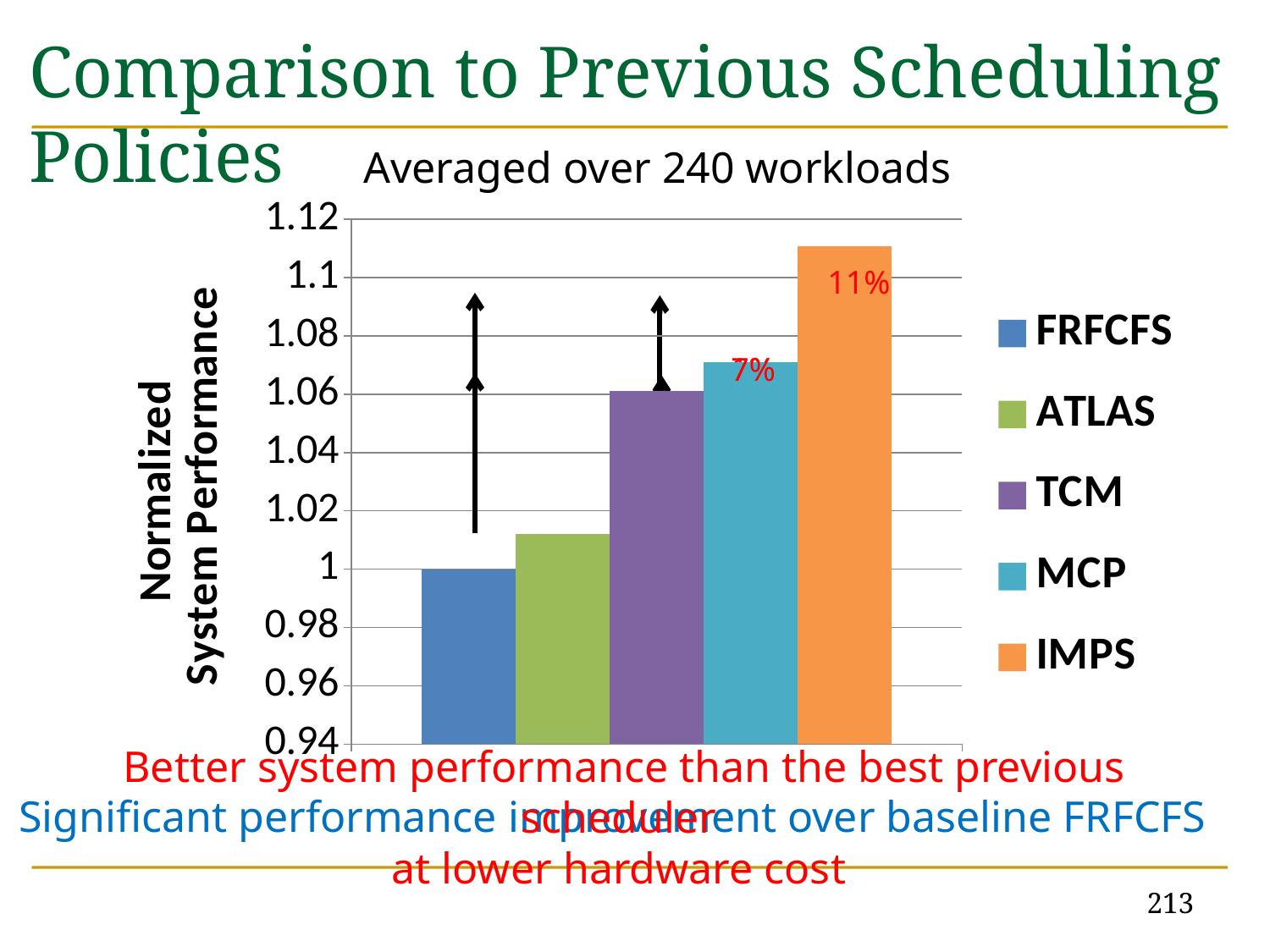
What is the normalized system performance value for FRFCFS? 1 What is the title shown above the chart? Averaged over 240 workloads Which scheduling policy has the highest normalized system performance? IMPS What kind of chart is shown on the slide? bar chart Do the bar values rise or fall from left to right across the chart? rise Which scheduling policy has the lowest normalized system performance? FRFCFS Is the normalized system performance for TCM greater or less than 1.04? greater Which has a higher normalized system performance, MCP or IMPS? IMPS How many series does the legend list? 5 Which has a higher normalized system performance, ATLAS or TCM? TCM Is the normalized system performance for IMPS greater or less than 1.1? greater Is the normalized system performance for ATLAS greater or less than 1.02? less